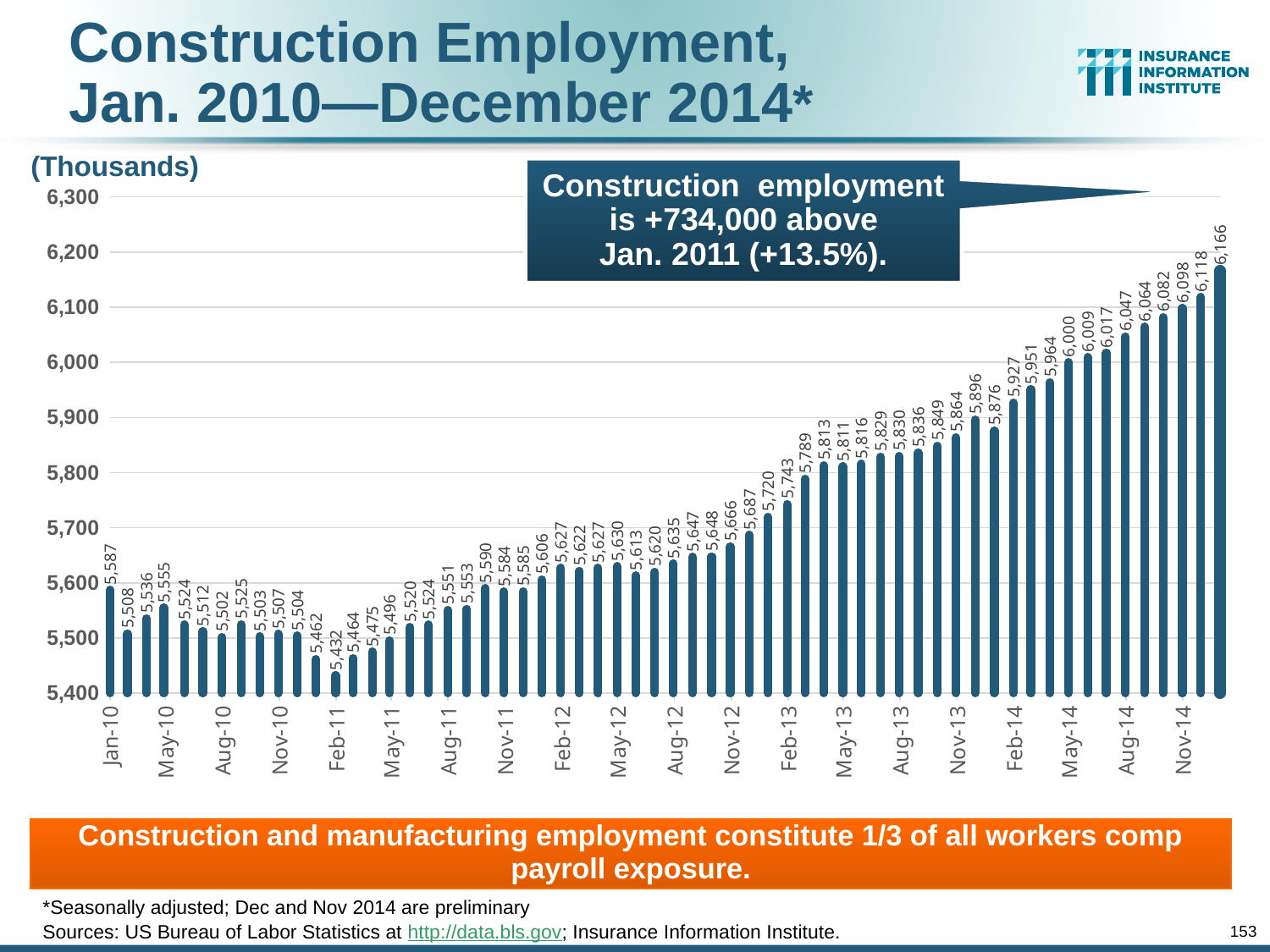
What type of chart is shown on the slide? Bar chart Overall, do the values rise or fall from Jan-10 to the end of 2014? Rise What is the construction employment value (thousands) for Feb-13? 5,789 Is the value for Nov-13 greater or less than 5,800? greater What is the difference between the values for Nov-14 and Jan-10? 531 What is the highest value shown on the chart? 6,166 What is the lowest value shown on the chart? 5,432 According to the callout box, how much is construction employment above Jan. 2011? +734,000 (+13.5%) What is the construction employment value (thousands) for Nov-14? 6,118 Which is larger, the value for Feb-11 or the value for Feb-12? Feb-12 What is the construction employment value (thousands) for Jan-10? 5,587 What is the difference between the values for Aug-14 and Aug-13? 228